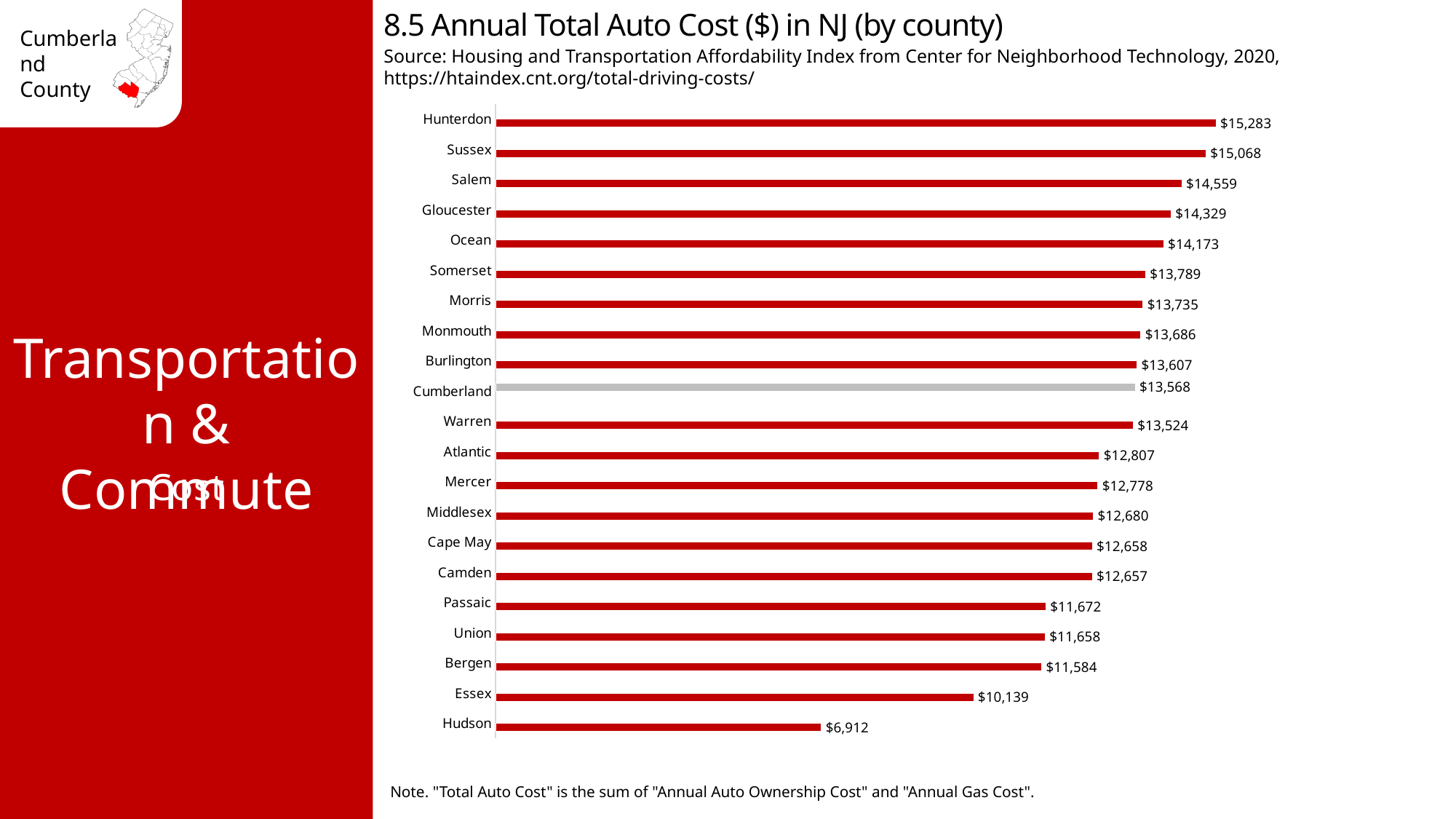
What kind of chart is used to show the annual total auto cost by county? Bar chart What is the annual total auto cost for Hudson county? $6,912 What is the annual total auto cost for Cumberland county? $13,568 Do the values rise or fall going from the top bar to the bottom bar? Fall Which county has a higher annual total auto cost, Salem or Essex? Salem What is the difference between the annual total auto cost of Cumberland and Hudson? $6,656 Which county has the lowest annual total auto cost? Hudson What is the annual total auto cost for Gloucester county? $14,329 Which county has the highest annual total auto cost? Hunterdon Which county's bar is coloured grey instead of red? Cumberland What is the difference between the annual total auto cost of Hunterdon and Hudson? $8,371 How many counties are shown in the chart? 21